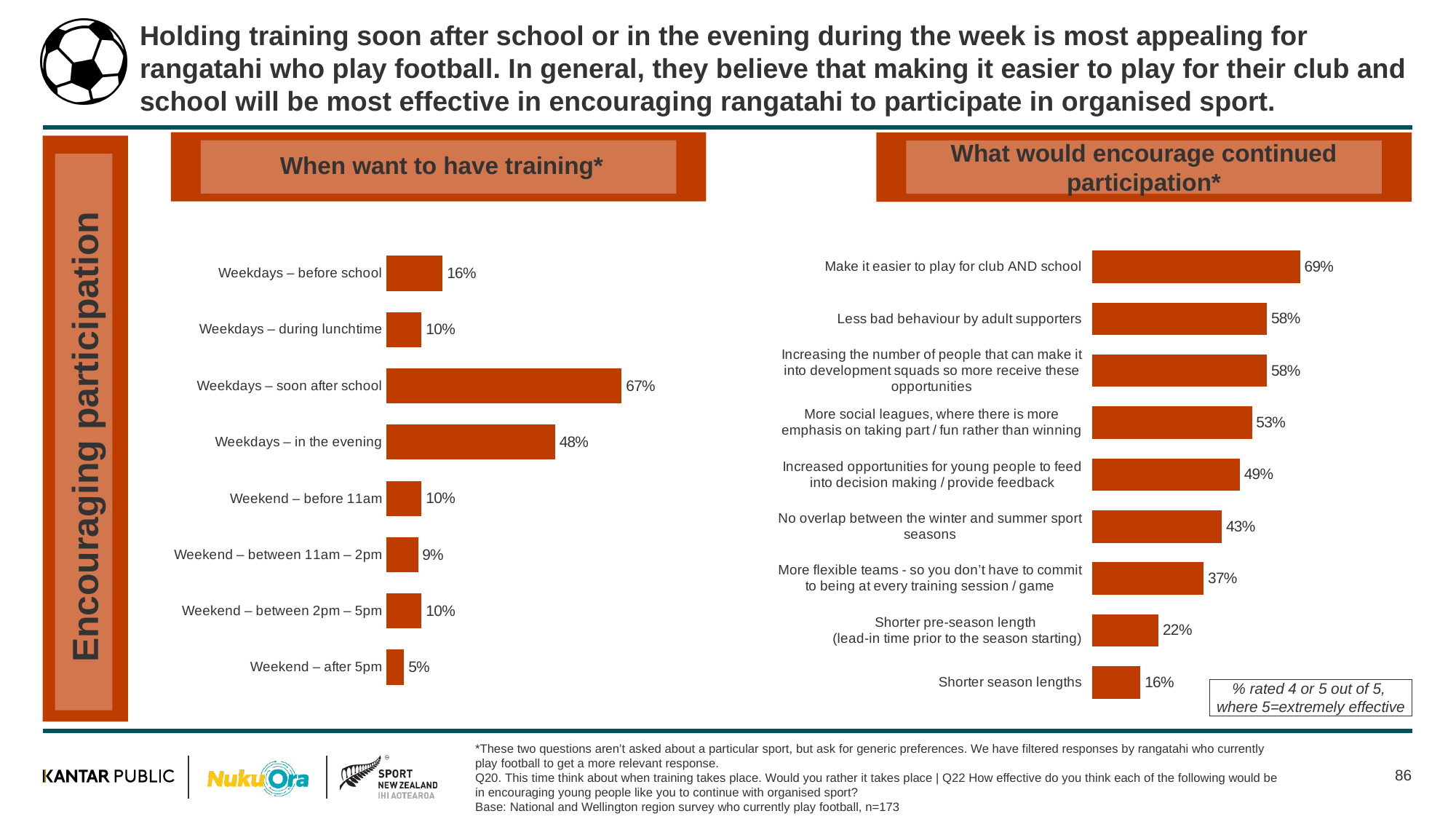
In the 'When want to have training*' chart, how many categories are shown? 8 In the 'What would encourage continued participation*' chart, what is the value for 'Shorter pre-season length (lead-in time prior to the season starting)'? 22% What type of chart is the 'When want to have training*' chart? Bar chart In the 'When want to have training*' chart, which is larger: 'Weekdays – before school' or 'Weekdays – during lunchtime'? Weekdays – before school In the 'What would encourage continued participation*' chart, what is the difference between 'Make it easier to play for club AND school' and 'Shorter season lengths'? 53 percentage points In the 'What would encourage continued participation*' chart, which is larger: 'No overlap between the winter and summer sport seasons' or 'More flexible teams - so you don't have to commit to being at every training session / game'? No overlap between the winter and summer sport seasons In the 'What would encourage continued participation*' chart, what is the value for 'Make it easier to play for club AND school'? 69% In the 'What would encourage continued participation*' chart, which category has the highest value? Make it easier to play for club AND school In the 'When want to have training*' chart, what is the value for 'Weekdays – soon after school'? 67% In the 'What would encourage continued participation*' chart, how many categories are shown? 9 In the 'When want to have training*' chart, which category has the lowest value? Weekend – after 5pm In the 'When want to have training*' chart, what is the difference between 'Weekdays – soon after school' and 'Weekdays – in the evening'? 19 percentage points